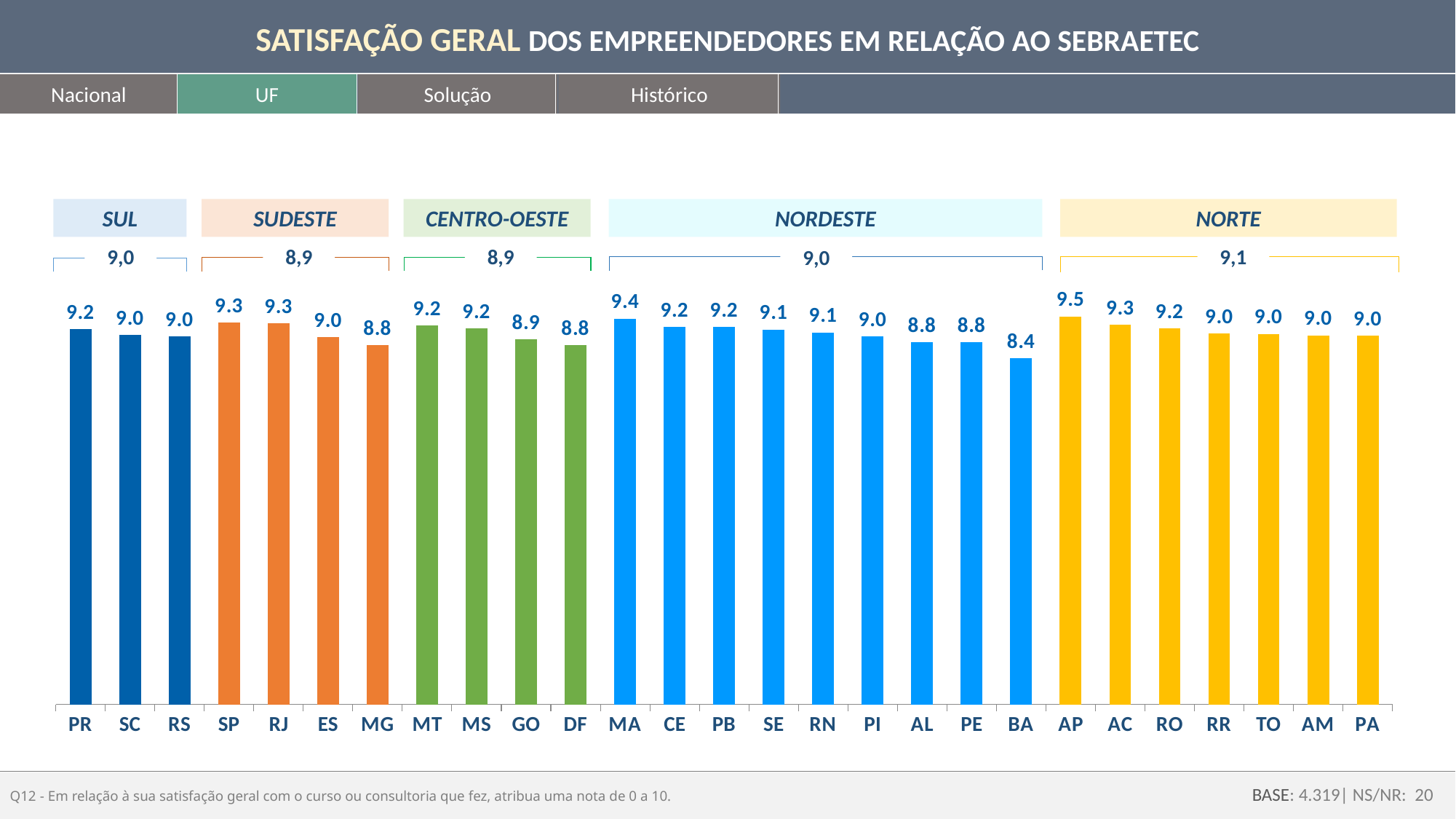
What is the value for MG? 8.8 Which is larger, the value for PR or the value for GO? PR What is the difference between the values for SP and MG? 0.5 How many states are in the NORDESTE group? 9 What is the difference between the values for AP and BA? 1.1 Which state has the highest value? AP How many states are shown in the chart? 27 What is the value for MA? 9.4 What is the value for BA? 8.4 What is the average value shown for the NORTE region? 9,1 What kind of chart is shown? Bar chart Which state has the lowest value? BA